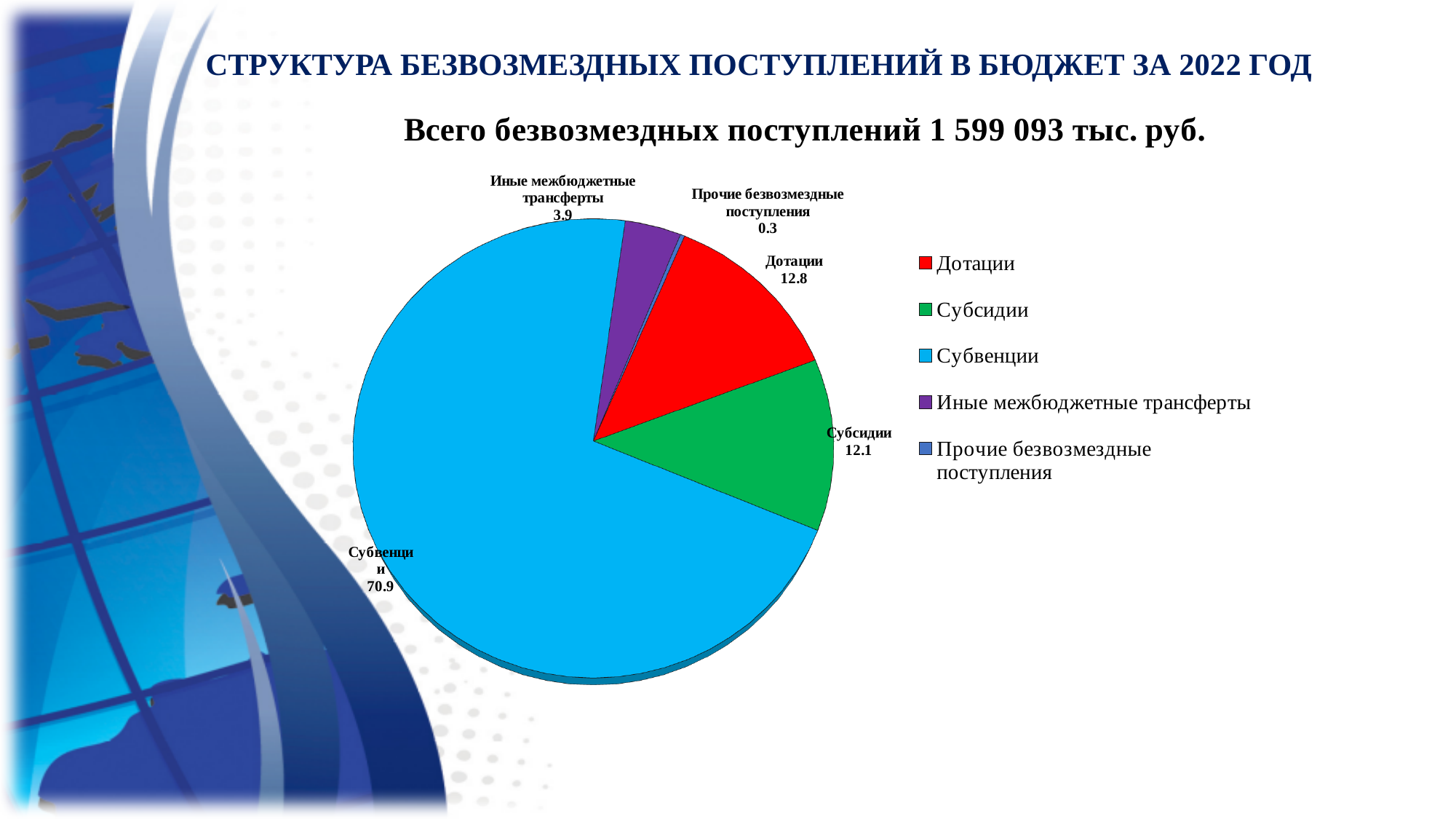
Which category has the largest slice of the pie? Субвенции What is the value shown for Субсидии? 12.1 Which is larger, the value for Субвенции or the value for Дотации? Субвенции What is the value shown for Иные межбюджетные трансферты? 3.9 What is the value shown for Прочие безвозмездные поступления? 0.3 What total amount of безвозмездные поступления is stated in the chart title? 1 599 093 тыс. руб. What kind of chart is shown on the slide? pie chart What is the difference between the values for Дотации and Субсидии? 0.7 What is the value shown for Дотации? 12.8 Which category has the smallest slice of the pie? Прочие безвозмездные поступления What is the value shown for Субвенции? 70.9 How many categories does the legend list? 5